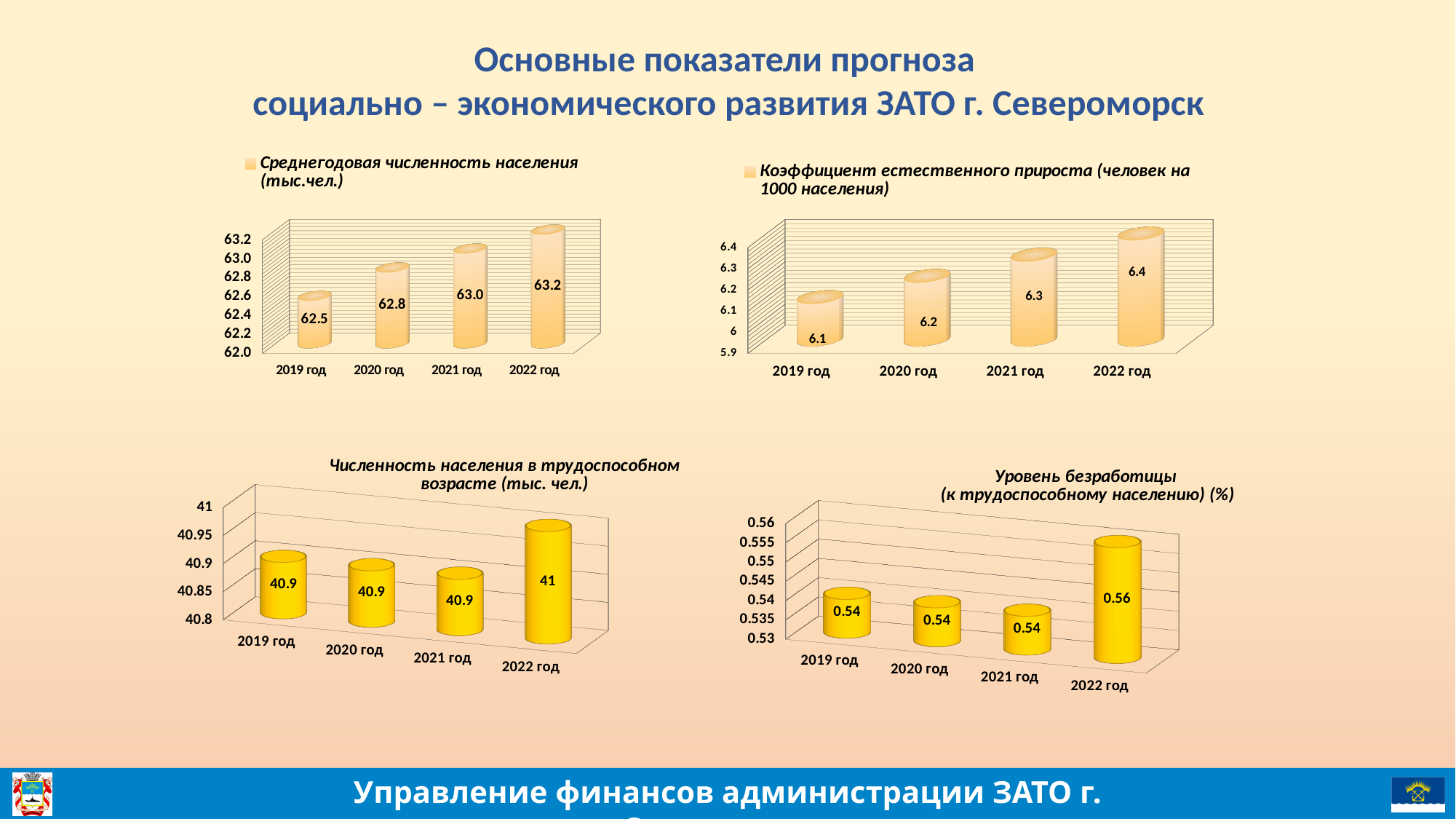
In the bottom-left chart (Численность населения в трудоспособном возрасте), which year has the highest value? 2022 год In the bottom-right chart (Уровень безработицы), what is the value for 2019 год? 0.54 How many years (categories) are shown in the bottom-right chart (Уровень безработицы)? 4 In the top-left chart (Среднегодовая численность населения), which year has the highest value? 2022 год In the bottom-left chart (Численность населения в трудоспособном возрасте), what is the value for 2022 год? 41 What kind of chart is the top-left chart (Среднегодовая численность населения)? bar chart In the top-left chart (Среднегодовая численность населения), what is the value for 2020 год? 62.8 In the top-right chart (Коэффициент естественного прироста), do the values rise or fall from 2019 год to 2022 год? rise In the top-left chart (Среднегодовая численность населения), what is the difference between the values for 2022 год and 2019 год? 0.7 In the bottom-right chart (Уровень безработицы), which is larger, the value for 2022 год or the value for 2021 год? 2022 год In the top-right chart (Коэффициент естественного прироста), what is the value for 2021 год? 6.3 In the top-right chart (Коэффициент естественного прироста), which year has the lowest value? 2019 год